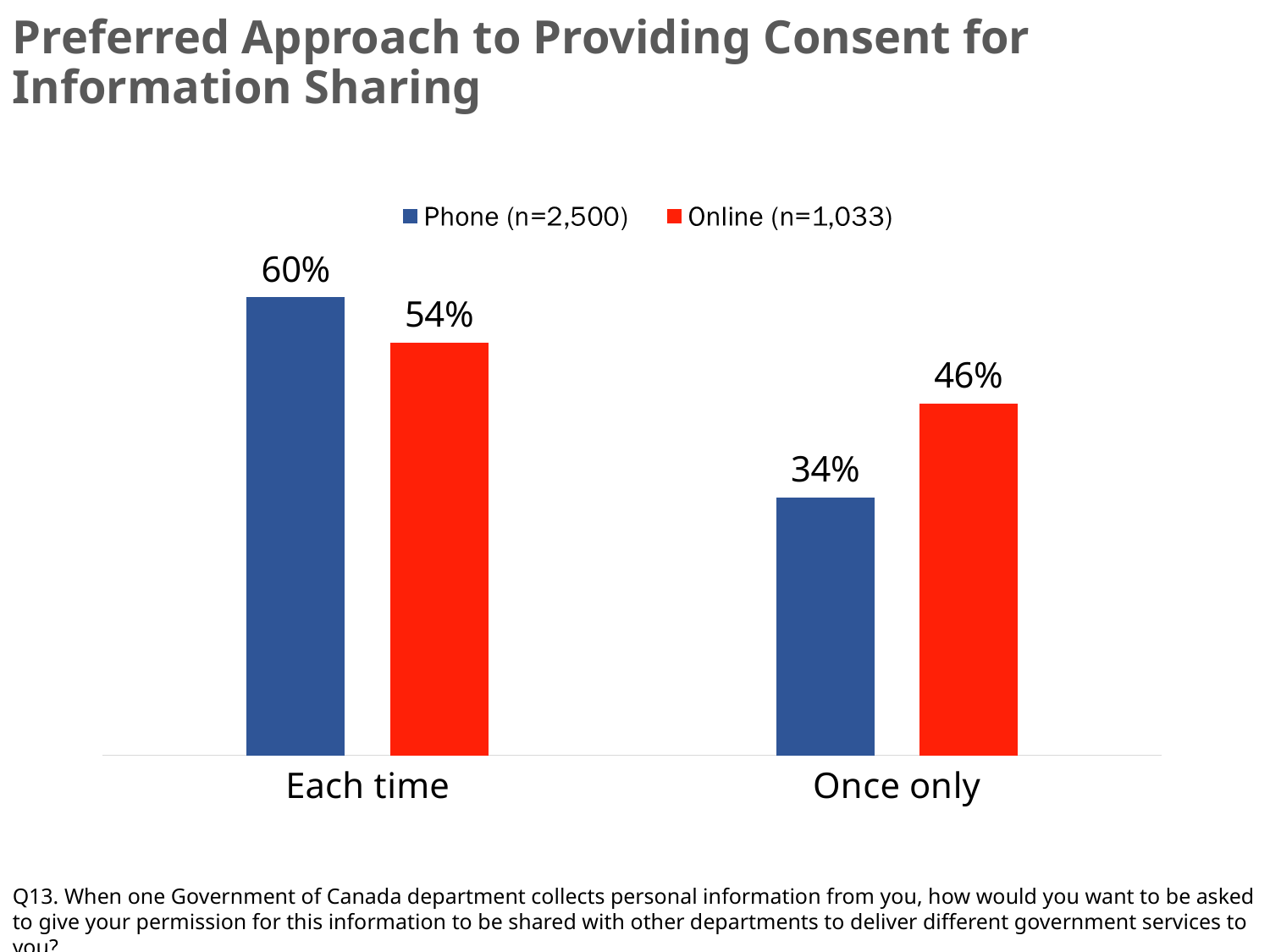
For 'Once only', which series has the larger value, Phone or Online? Online How many categories are shown on the x axis? 2 What is the value for Phone (n=2,500) in the 'Once only' category? 34% What is the difference between the Phone and Online values for 'Once only'? 12 percentage points What is the value for Online (n=1,033) in the 'Each time' category? 54% Which category has the lowest value for the Online series? Once only Which category has the highest value for the Phone series? Each time What percentage of Online respondents preferred 'Once only'? 46% What percentage of Phone respondents preferred 'Each time'? 60% What is the difference between the Phone and Online values for 'Each time'? 6 percentage points How many series does the legend list? 2 What type of chart is shown on the slide? Bar chart